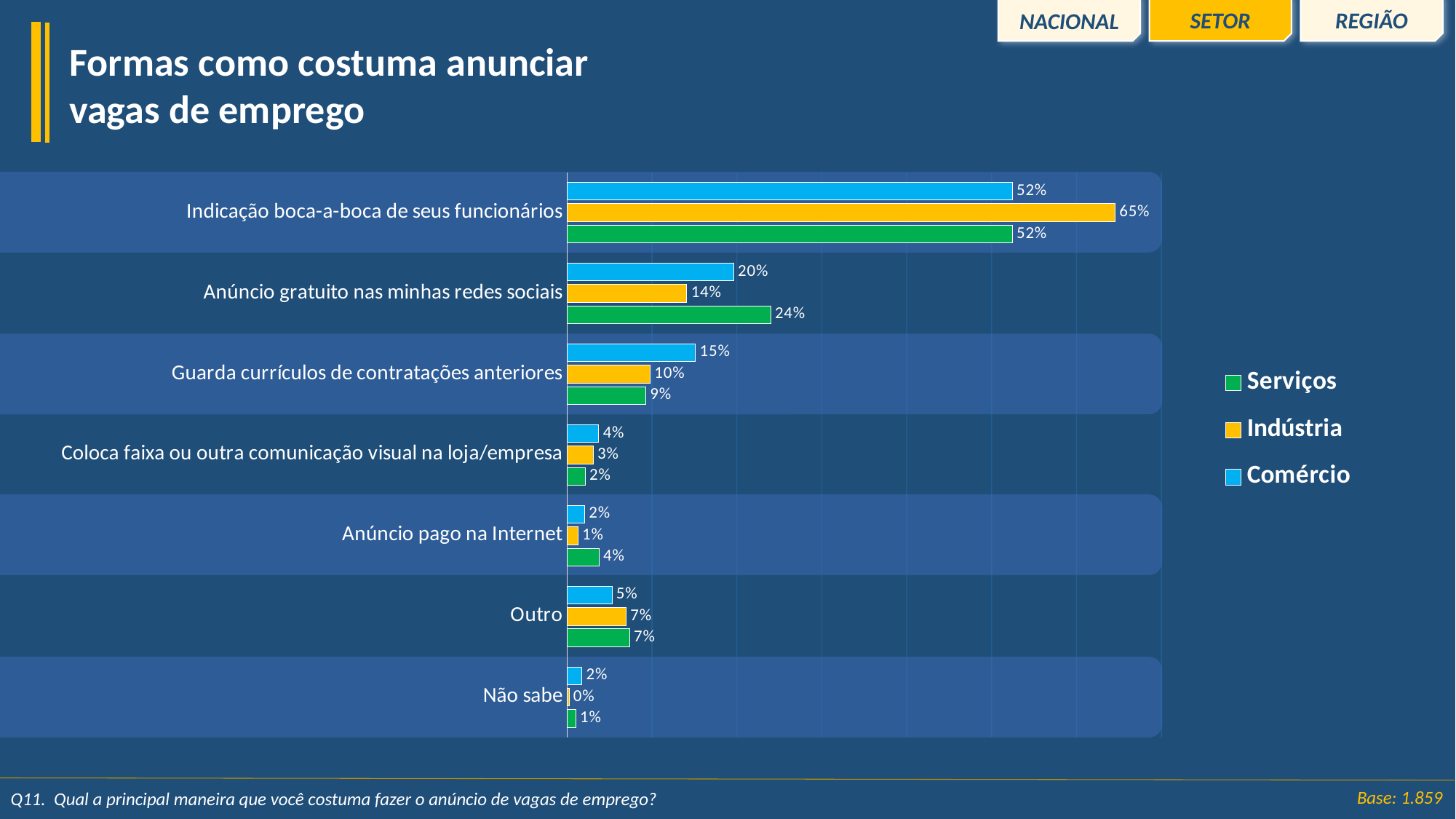
For "Anúncio pago na Internet", which series has the larger value, Serviços or Comércio? Serviços Which colour represents the Indústria series in the legend? Yellow What is the difference between the Indústria and Comércio values for "Indicação boca-a-boca de seus funcionários"? 13% How many categories are shown on the chart? 7 What is the Serviços value for "Anúncio gratuito nas minhas redes sociais"? 24% Which category has the highest Comércio value? Indicação boca-a-boca de seus funcionários What is the Indústria value for "Não sabe"? 0% Which category has the lowest Serviços value? Não sabe What is the Indústria value for "Indicação boca-a-boca de seus funcionários"? 65% What is the Comércio value for "Guarda currículos de contratações anteriores"? 15% What kind of chart is shown on the slide? Bar chart How many series does the legend list? 3